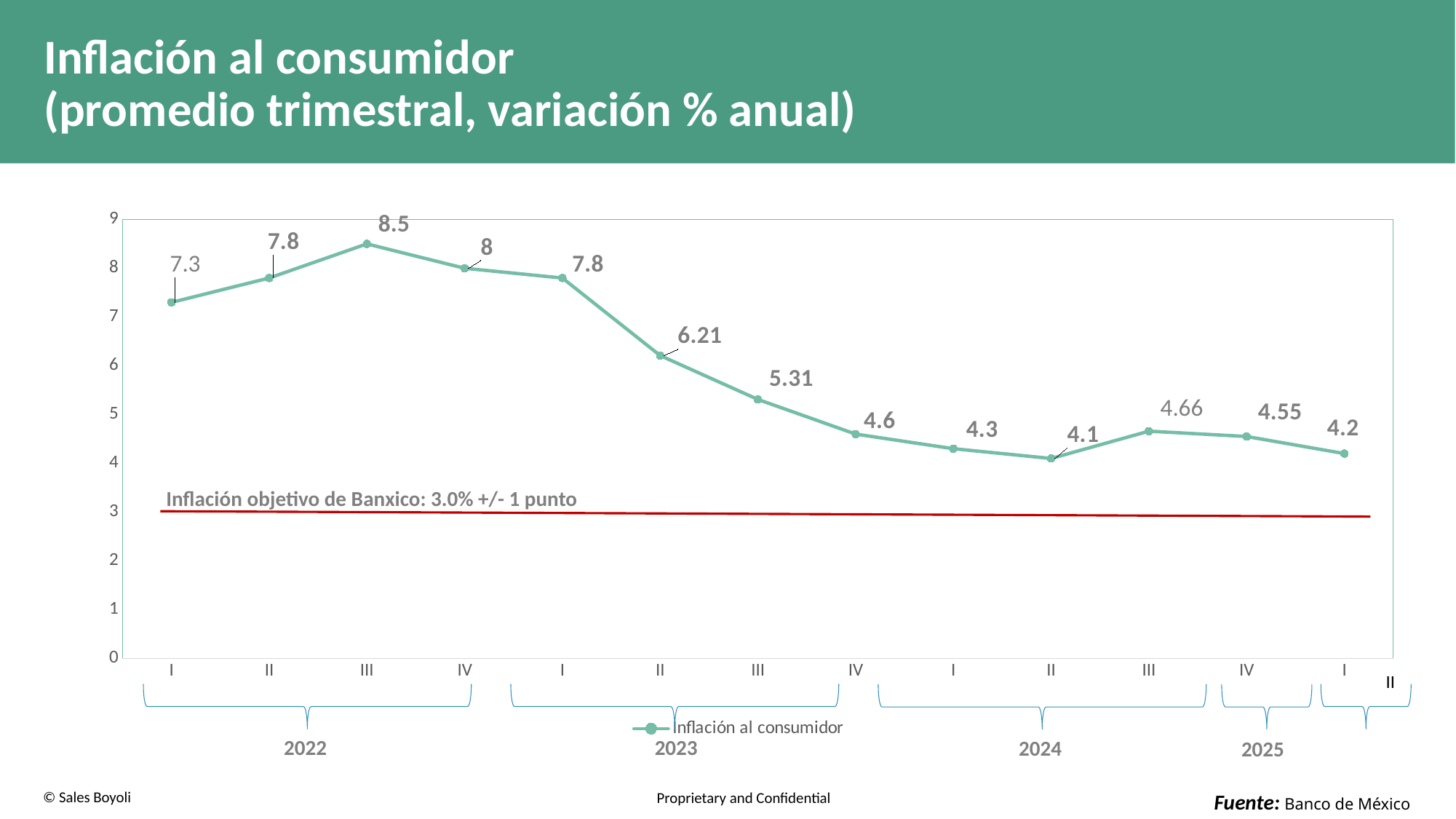
What is the value for quarter III of 2022? 8.5 Which quarter has the lowest inflation value? II 2024 How many series does the legend list? 1 Do the values rise or fall from quarter I of 2023 to quarter II of 2024? fall Which quarter has the highest inflation value? III 2022 What is the value for quarter II of 2023? 6.21 How many data points are plotted on the line? 13 What type of chart is shown on the slide? line chart What is the difference between the values for quarter III of 2022 and quarter I of 2022? 1.2 Is the value for quarter IV of 2023 greater or less than 5? less What is the value for quarter I of 2025? 4.2 Which is larger, the value for quarter III of 2024 or quarter IV of 2024? III 2024